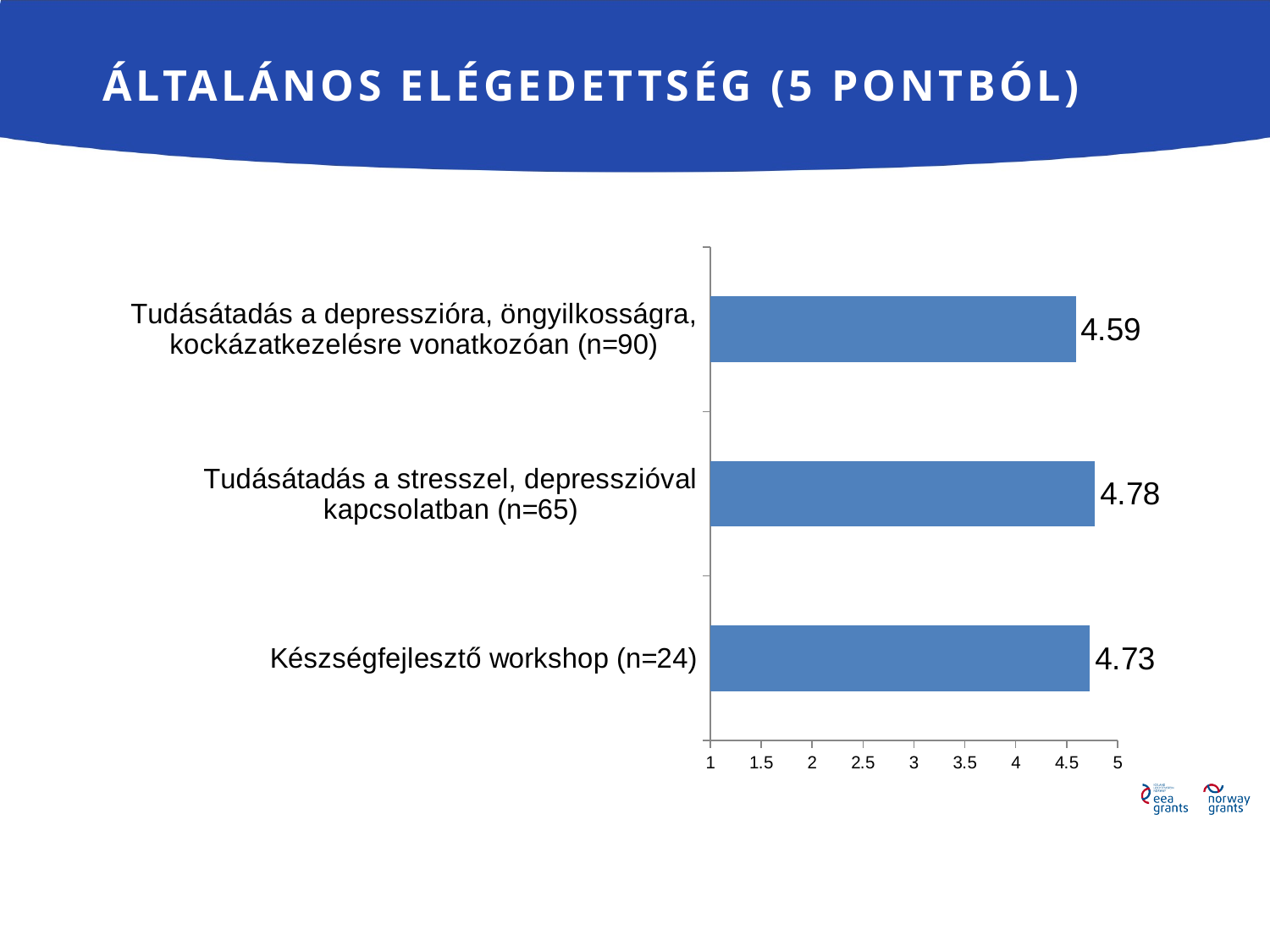
What is the value for "Tudásátadás a stresszel, depresszióval kapcsolatban (n=65)"? 4.78 Which is larger: the value for "Készségfejlesztő workshop (n=24)" or the value for "Tudásátadás a depresszióra, öngyilkosságra, kockázatkezelésre vonatkozóan (n=90)"? Készségfejlesztő workshop (n=24) What kind of chart is shown on the slide? bar chart What is the value for "Készségfejlesztő workshop (n=24)"? 4.73 What is the difference between the values for "Tudásátadás a stresszel, depresszióval kapcsolatban (n=65)" and "Tudásátadás a depresszióra, öngyilkosságra, kockázatkezelésre vonatkozóan (n=90)"? 0.19 Which category has the lowest value? Tudásátadás a depresszióra, öngyilkosságra, kockázatkezelésre vonatkozóan (n=90) Is the value for "Tudásátadás a depresszióra, öngyilkosságra, kockázatkezelésre vonatkozóan (n=90)" greater or less than 4.5? greater What is the value for "Tudásátadás a depresszióra, öngyilkosságra, kockázatkezelésre vonatkozóan (n=90)"? 4.59 What is the difference between the values for "Tudásátadás a stresszel, depresszióval kapcsolatban (n=65)" and "Készségfejlesztő workshop (n=24)"? 0.05 What is the title of the slide? ÁLTALÁNOS ELÉGEDETTSÉG (5 PONTBÓL) Which category has the highest value? Tudásátadás a stresszel, depresszióval kapcsolatban (n=65) How many categories are shown in the chart? 3